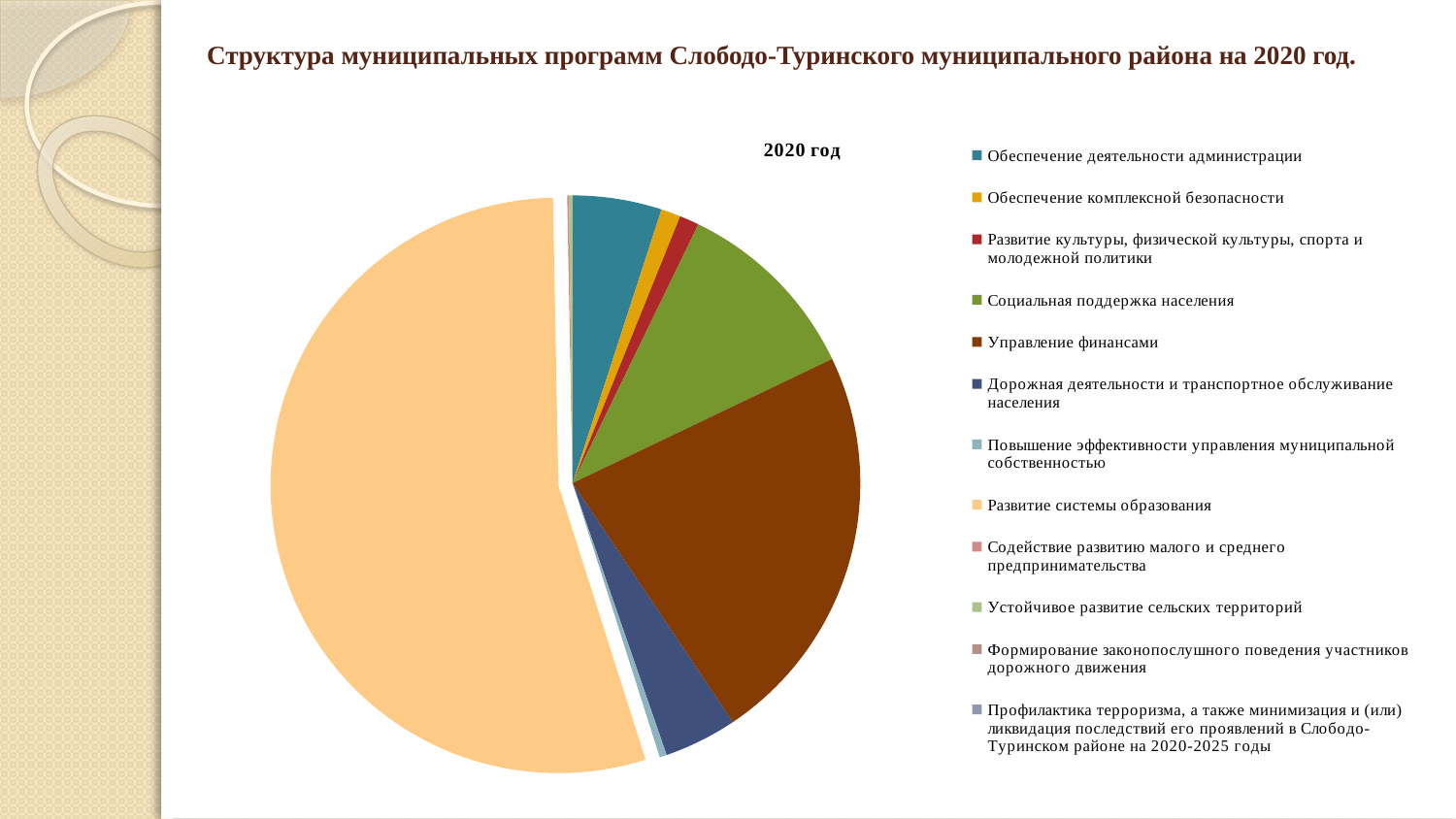
Which slice is larger: Развитие системы образования or Управление финансами? Развитие системы образования Which category has the largest slice of the pie chart? Развитие системы образования Which slice is larger: Обеспечение деятельности администрации or Обеспечение комплексной безопасности? Обеспечение деятельности администрации Which slice is larger: Управление финансами or Социальная поддержка населения? Управление финансами What is the title shown above the pie chart? 2020 год What kind of chart is shown on the slide? pie chart Which category is shown in dark brown in the pie chart? Управление финансами How many categories does the legend of the pie chart list? 12